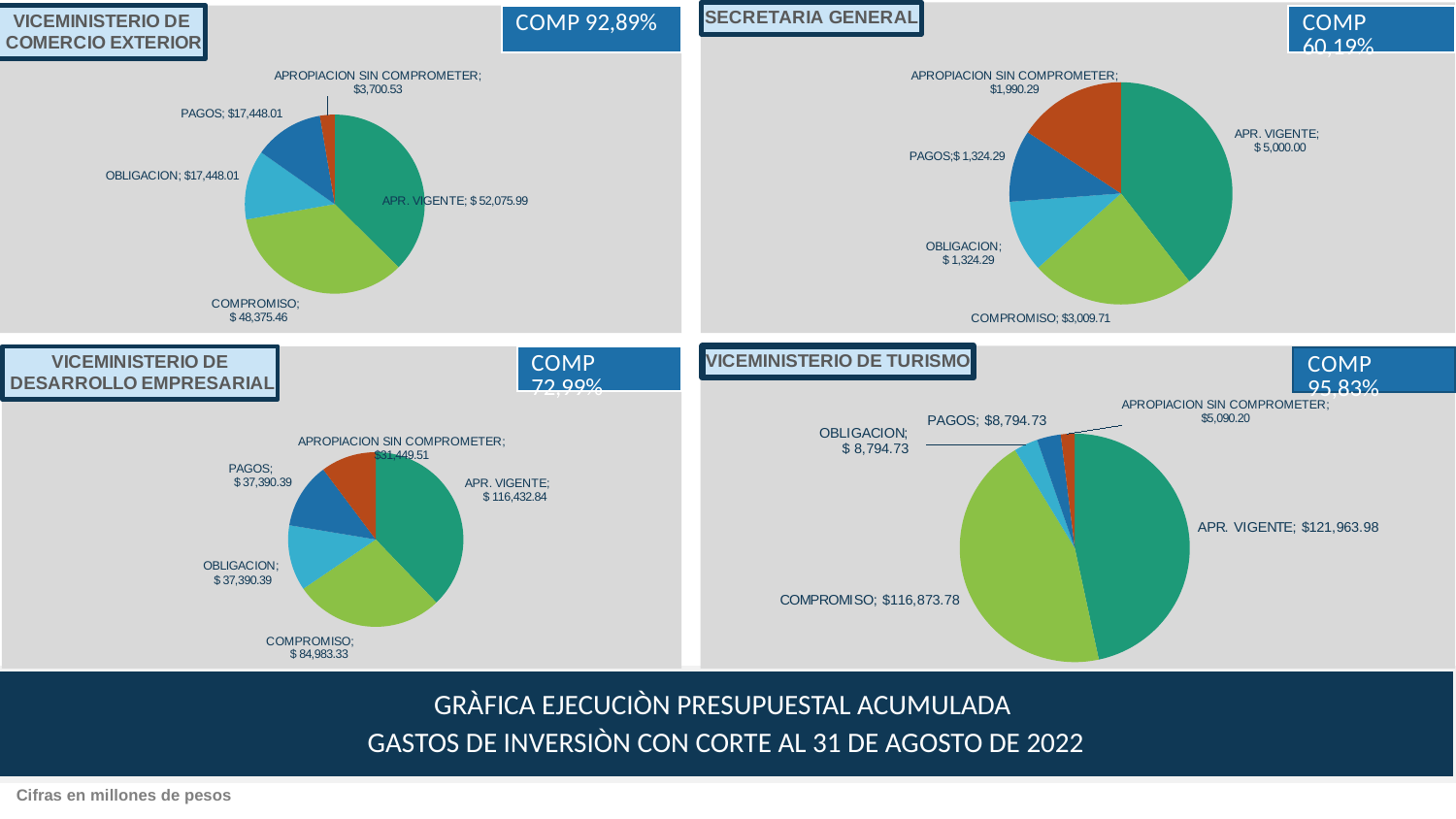
In the SECRETARIA GENERAL chart, what is the value for COMPROMISO? $3,009.71 In the VICEMINISTERIO DE DESARROLLO EMPRESARIAL chart, what is the value for APROPIACION SIN COMPROMETER? $31,449.51 In the VICEMINISTERIO DE DESARROLLO EMPRESARIAL chart, which is larger, COMPROMISO or PAGOS? COMPROMISO What type of charts are shown on the slide? Pie charts In the SECRETARIA GENERAL chart, what is the difference between APR. VIGENTE and COMPROMISO? $1,990.29 In the VICEMINISTERIO DE COMERCIO EXTERIOR chart, which category has the smallest slice? APROPIACION SIN COMPROMETER In the VICEMINISTERIO DE COMERCIO EXTERIOR chart, what is the value for APR. VIGENTE? $ 52,075.99 In the VICEMINISTERIO DE TURISMO chart, what is the difference between APR. VIGENTE and COMPROMISO? $5,090.20 In the VICEMINISTERIO DE TURISMO chart, what is the value for PAGOS? $8,794.73 In the VICEMINISTERIO DE TURISMO chart, which category has the largest slice? APR. VIGENTE How many pie charts are shown on the slide? 4 How many slices does the SECRETARIA GENERAL pie chart have? 5